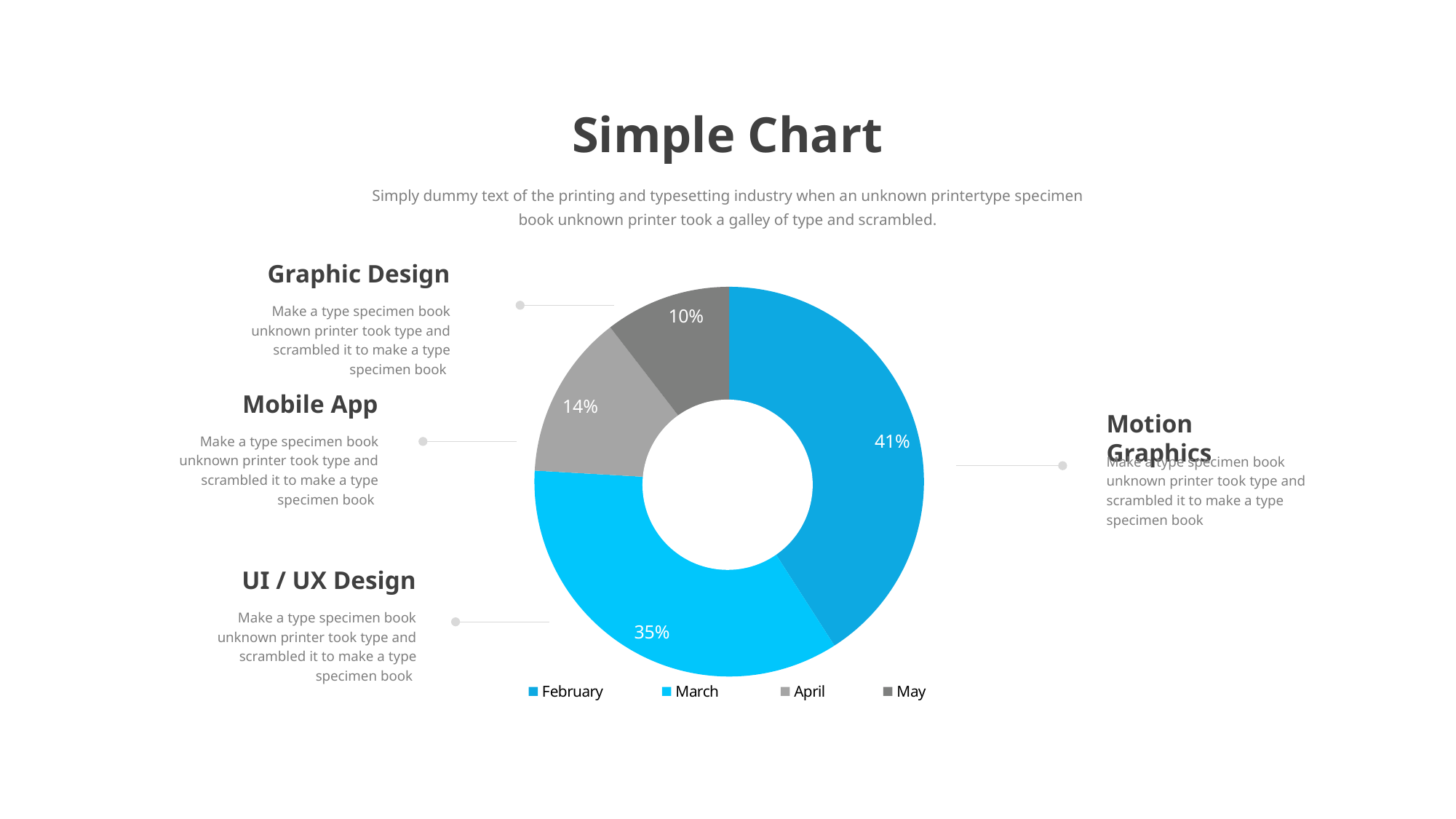
What percentage is shown for May? 10% What percentage is shown for March? 35% How many categories does the legend list? 4 What percentage is shown for April? 14% Which category has the smallest share of the chart? May Which category has the largest share of the chart? February What kind of chart is shown on the slide? Doughnut (pie) chart What is the title of the slide containing the chart? Simple Chart What colour is the May slice in the chart? Dark grey What is the difference in percentage points between February and March? 6 Which is larger, the share for April or the share for May? April What percentage is shown for February? 41%